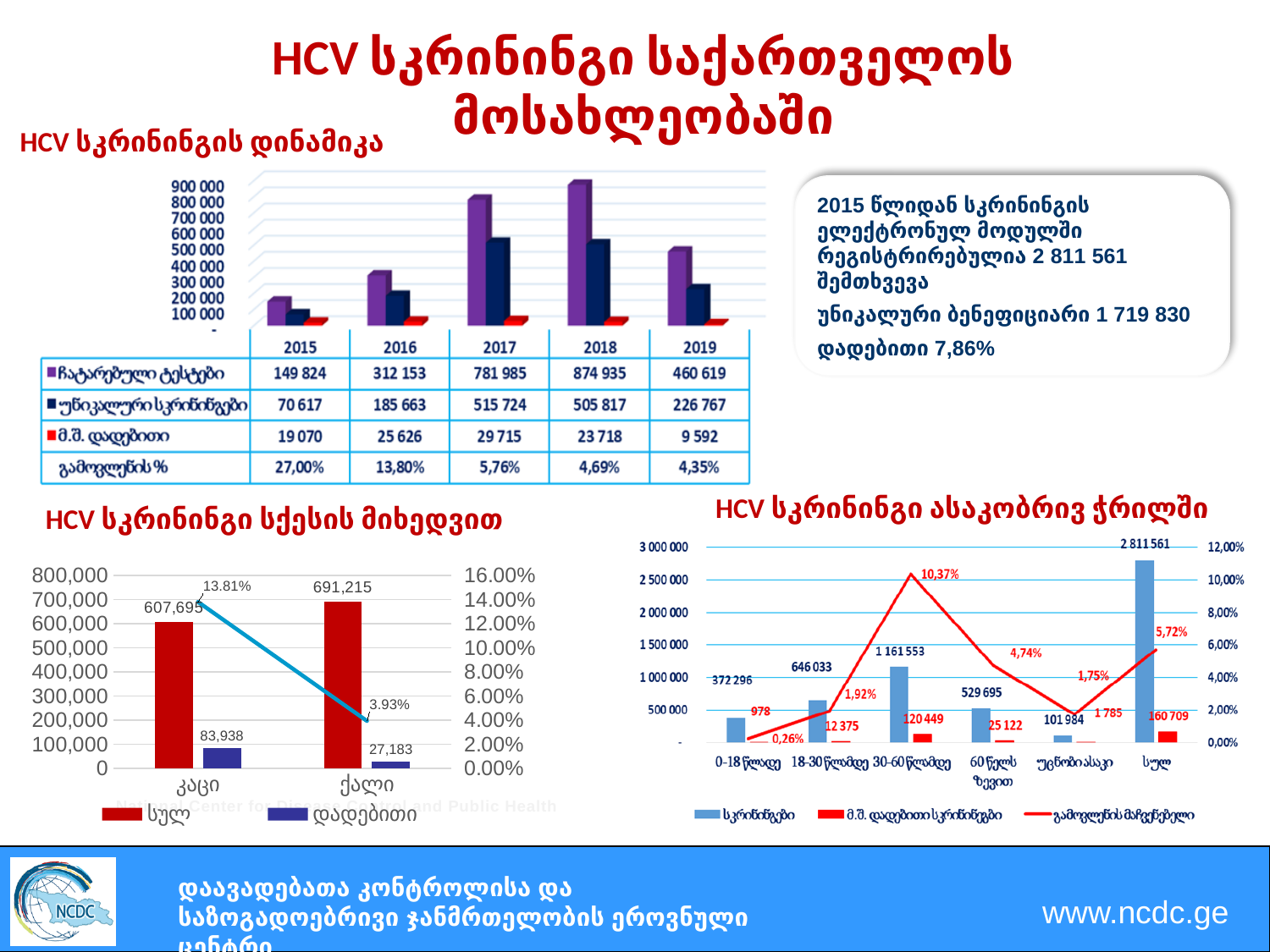
In the 'HCV სკრინინგი ასაკობრივ ჭრილში' chart, which age group has the highest გამოვლენის მაჩვენებელი? 30-60 წლამდე In the 'HCV სკრინინგი ასაკობრივ ჭრილში' chart, how many series does the legend list? 3 In the 'HCV სკრინინგი ასაკობრივ ჭრილში' chart, what is the სკრინინგები value for 30-60 წლამდე? 1 161 553 In the 'HCV სკრინინგის დინამიკა' chart, which year has the lowest value of მ.შ. დადებითი? 2019 In the 'HCV სკრინინგი სქესის მიხედვით' chart, what is the სულ value for ქალი? 691,215 In the 'HCV სკრინინგის დინამიკა' chart, what is the difference between უნიკალური სკრინინგები in 2017 and 2018? 9 907 In the 'HCV სკრინინგის დინამიკა' chart, what is the გამოვლენის % for 2015? 27,00% In the 'HCV სკრინინგის დინამიკა' chart, what is the value of ჩატარებული ტესტები for 2018? 874 935 In the 'HCV სკრინინგის დინამიკა' chart, how many years are shown on the x axis? 5 In the 'HCV სკრინინგი სქესის მიხედვით' chart, what is the difference between the დადებითი values for კაცი and ქალი? 56,755 In the 'HCV სკრინინგის დინამიკა' chart, which year has the highest value of ჩატარებული ტესტები? 2018 In the 'HCV სკრინინგი სქესის მიხედვით' chart, what percentage is shown for კაცი? 13.81%